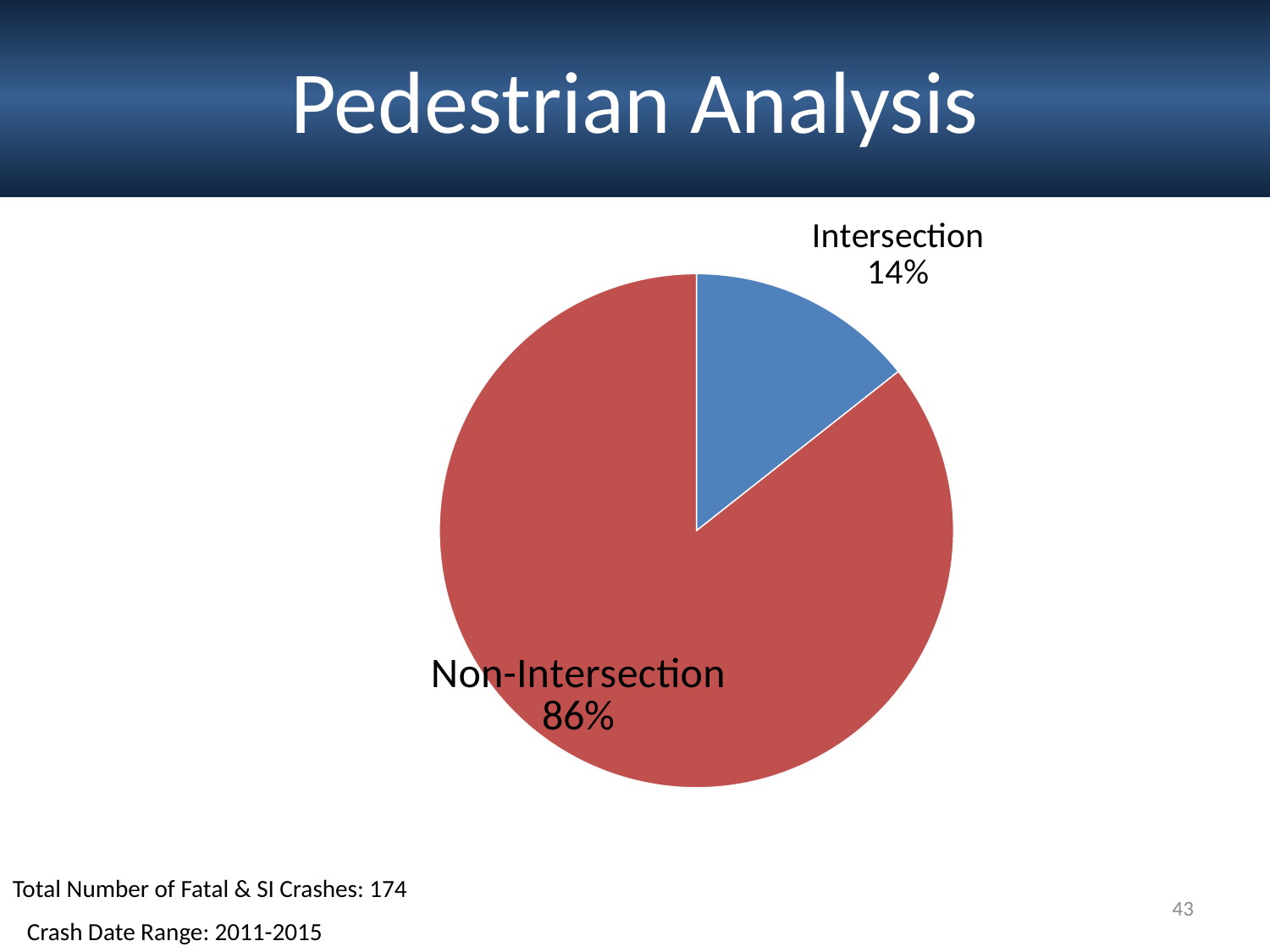
Is the Intersection share greater or less than 50%? less Which slice of the pie is the smallest? Intersection What is the title of the slide containing the pie chart? Pedestrian Analysis What is the difference in percentage points between the Non-Intersection and Intersection slices? 72 What colour is the Non-Intersection slice of the pie? red How many slices does the pie chart have? 2 What kind of chart is shown on the slide? pie chart Which is larger, the Intersection slice or the Non-Intersection slice? Non-Intersection What share of the pie does the Intersection slice represent? 14% Which slice of the pie is the largest? Non-Intersection What share of the pie does the Non-Intersection slice represent? 86%